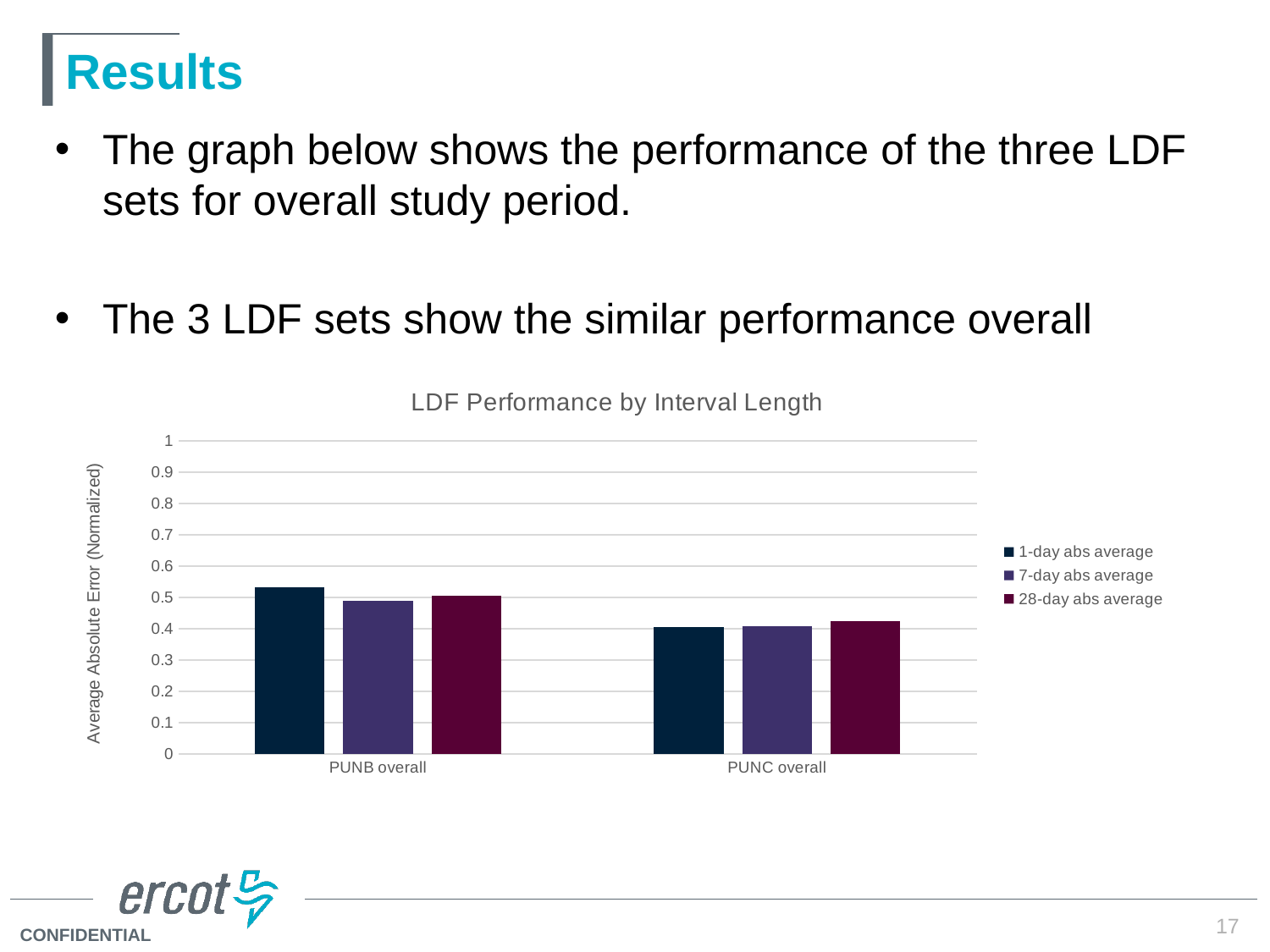
Is the 1-day abs average value for PUNC overall greater or less than 0.5? less Is the 1-day abs average value for PUNB overall greater or less than 0.5? greater Within the PUNB overall category, which series has the highest value? 1-day abs average Do the 1-day abs average values rise or fall from PUNB overall to PUNC overall? fall What is the label of the vertical axis? Average Absolute Error (Normalized) Is the 7-day abs average value for PUNB overall greater or less than 0.4? greater How many series does the chart's legend list? 3 What type of chart is shown on the slide? bar chart Which is larger, the 1-day abs average for PUNB overall or the 1-day abs average for PUNC overall? PUNB overall What is the title of the chart? LDF Performance by Interval Length How many categories are shown on the x axis of the chart? 2